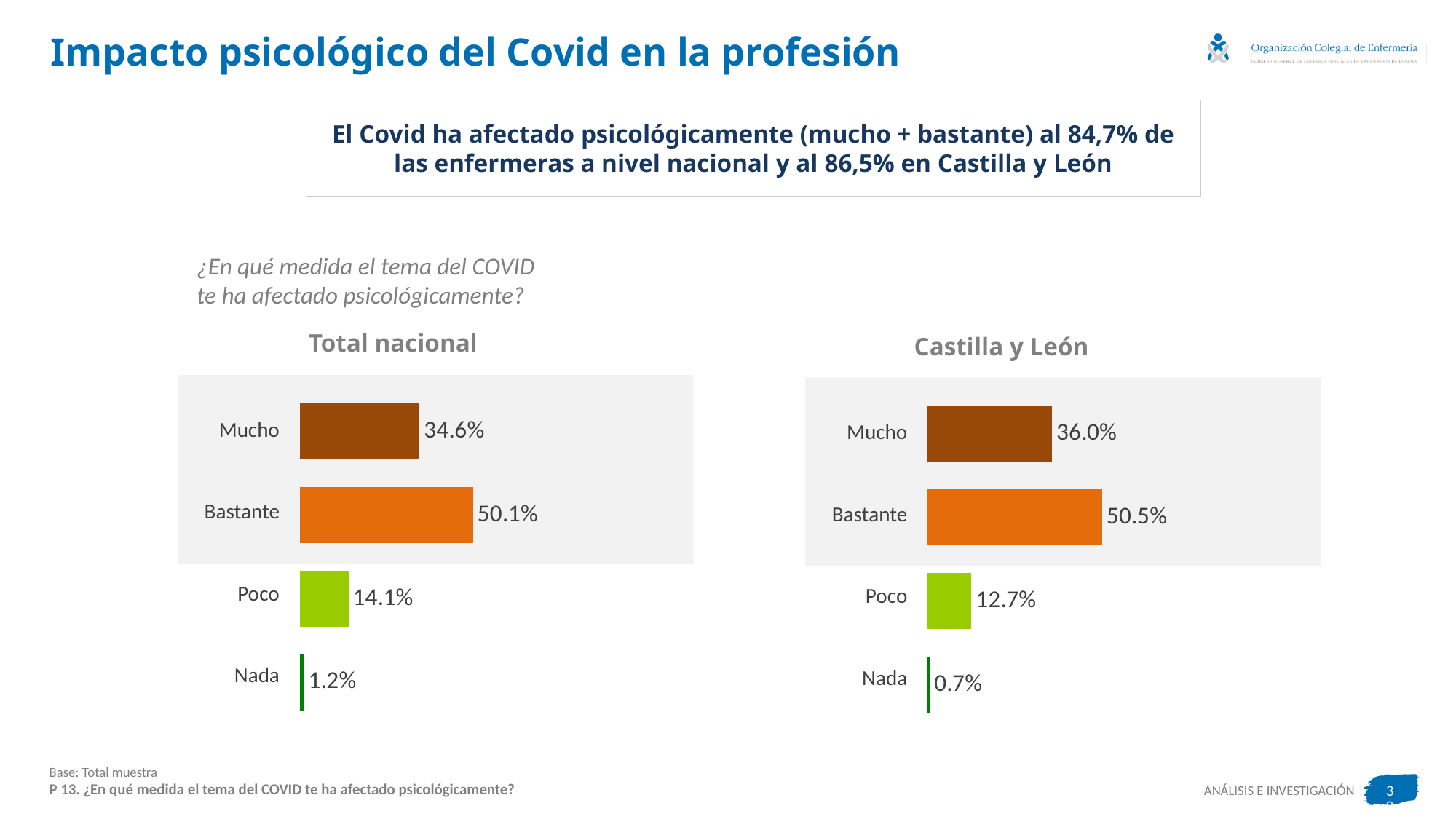
In the 'Total nacional' chart, which category has the highest value? Bastante In the 'Castilla y León' chart, what is the value for Poco? 12.7% How many categories does the 'Castilla y León' chart show? 4 Which is larger: the value for Mucho in the 'Total nacional' chart or the value for Mucho in the 'Castilla y León' chart? Castilla y León In the 'Total nacional' chart, what is the value for Nada? 1.2% In the 'Total nacional' chart, what is the value for Bastante? 50.1% What is the title of the chart on the right side of the slide? Castilla y León In the 'Castilla y León' chart, what is the value for Mucho? 36.0% What kind of chart is the 'Total nacional' chart? Bar chart In the 'Total nacional' chart, what is the difference between the values for Bastante and Mucho? 15.5% In the 'Castilla y León' chart, which category has the lowest value? Nada In the 'Castilla y León' chart, what is the difference between the values for Poco and Nada? 12.0%